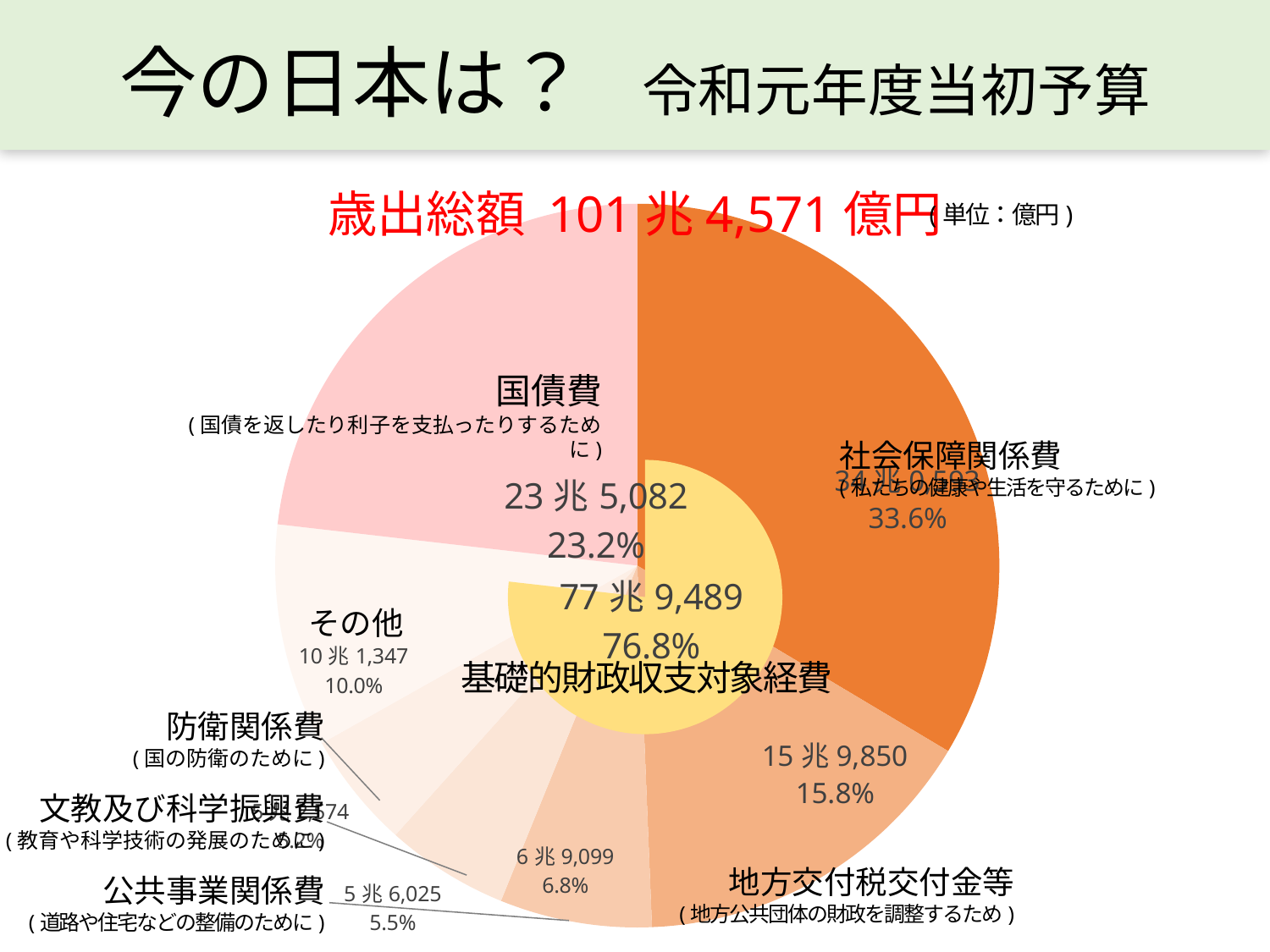
What is the difference in percentage points between the share of 社会保障関係費 (33.6%) and 国債費 (23.2%)? 10.4 percentage points What unit is stated for the values on the chart? 億円 What is the value shown for その他? 10兆1,347 What share of the pie does 社会保障関係費 represent? 33.6% What share of the pie does 国債費 represent? 23.2% What is the total expenditure (歳出総額) shown above the chart? 101兆4,571億円 What kind of chart is shown on the slide? pie chart What is the value shown for 国債費? 23兆5,082 What share is shown for 基礎的財政収支対象経費 in the inner ring? 76.8% Which is larger, the share for 国債費 or the share for 地方交付税交付金等? 国債費 What is the value shown for 地方交付税交付金等? 15兆9,850 Which category has the largest share of the pie? 社会保障関係費